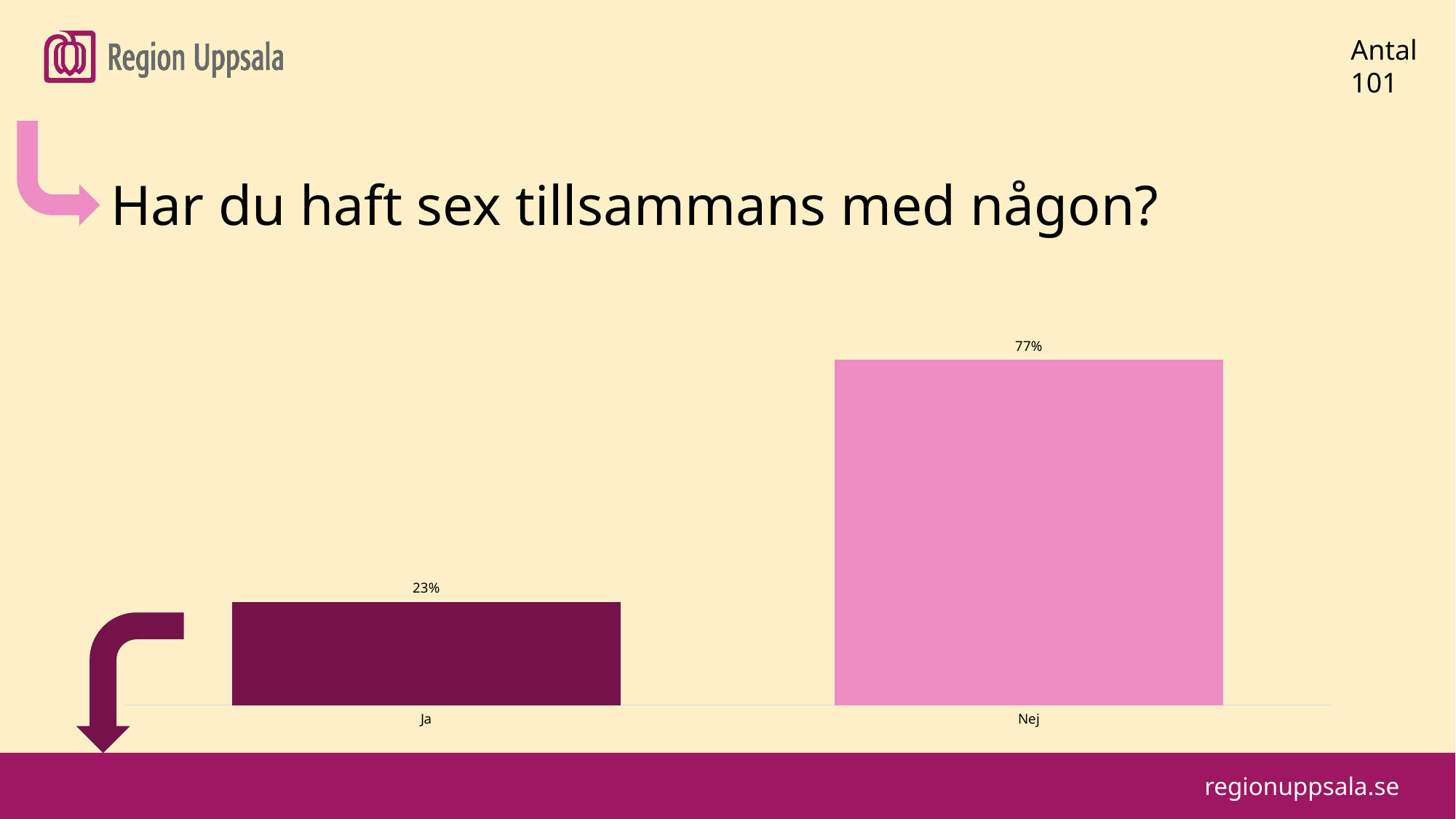
How many categories are shown in the chart? 2 What is the value for "Ja"? 23% What is the value for "Nej"? 77% Which category has the lowest value? Ja What is the number of respondents (Antal) shown on the slide? 101 Which category has the highest value? Nej What is the total of the two values shown in the chart? 100% What kind of chart is shown on the slide? Bar chart Which is larger, the value for "Ja" or the value for "Nej"? Nej What question does the chart title ask? Har du haft sex tillsammans med någon? What is the difference between the values for "Nej" and "Ja"? 54%